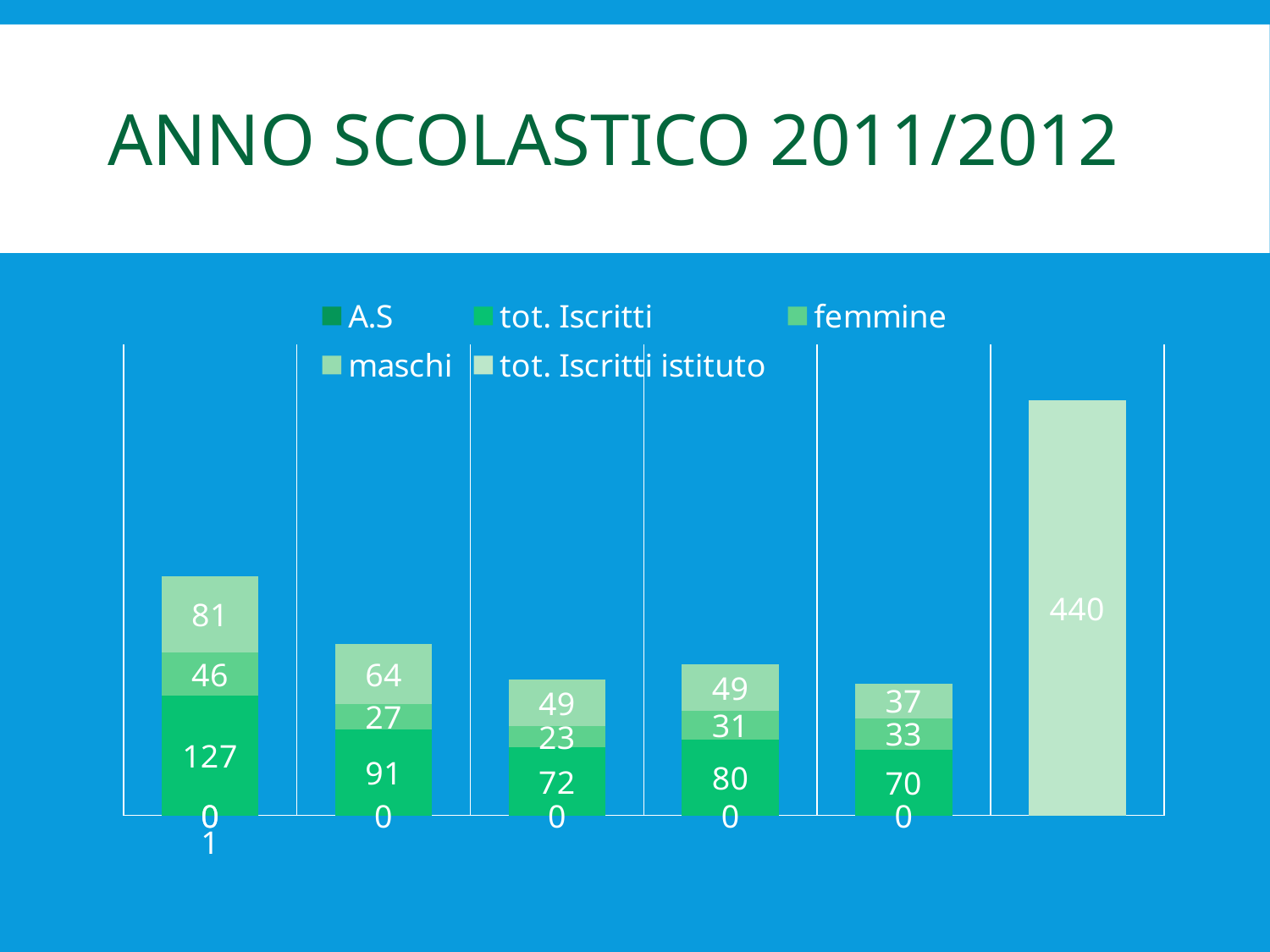
How many series does the chart legend list? 5 Which is larger: the femmine value in the fourth bar or the femmine value in the fifth bar? the fifth bar (33) What kind of chart is shown on the slide? bar chart What is the maschi value shown in the fifth bar? 37 How many bars are plotted in the chart? 6 What is the femmine value shown in the second bar? 27 Among the first five bars, which bar has the highest tot. Iscritti value? the first bar (127) What is the tot. Iscritti value shown in the first (leftmost) bar? 127 What is the difference between the maschi value in the first bar (81) and the maschi value in the second bar (64)? 17 What is the title of the slide containing the chart? ANNO SCOLASTICO 2011/2012 What value is shown on the rightmost bar (tot. Iscritti istituto)? 440 Among the first five bars, which bar has the lowest tot. Iscritti value? the fifth bar (70)